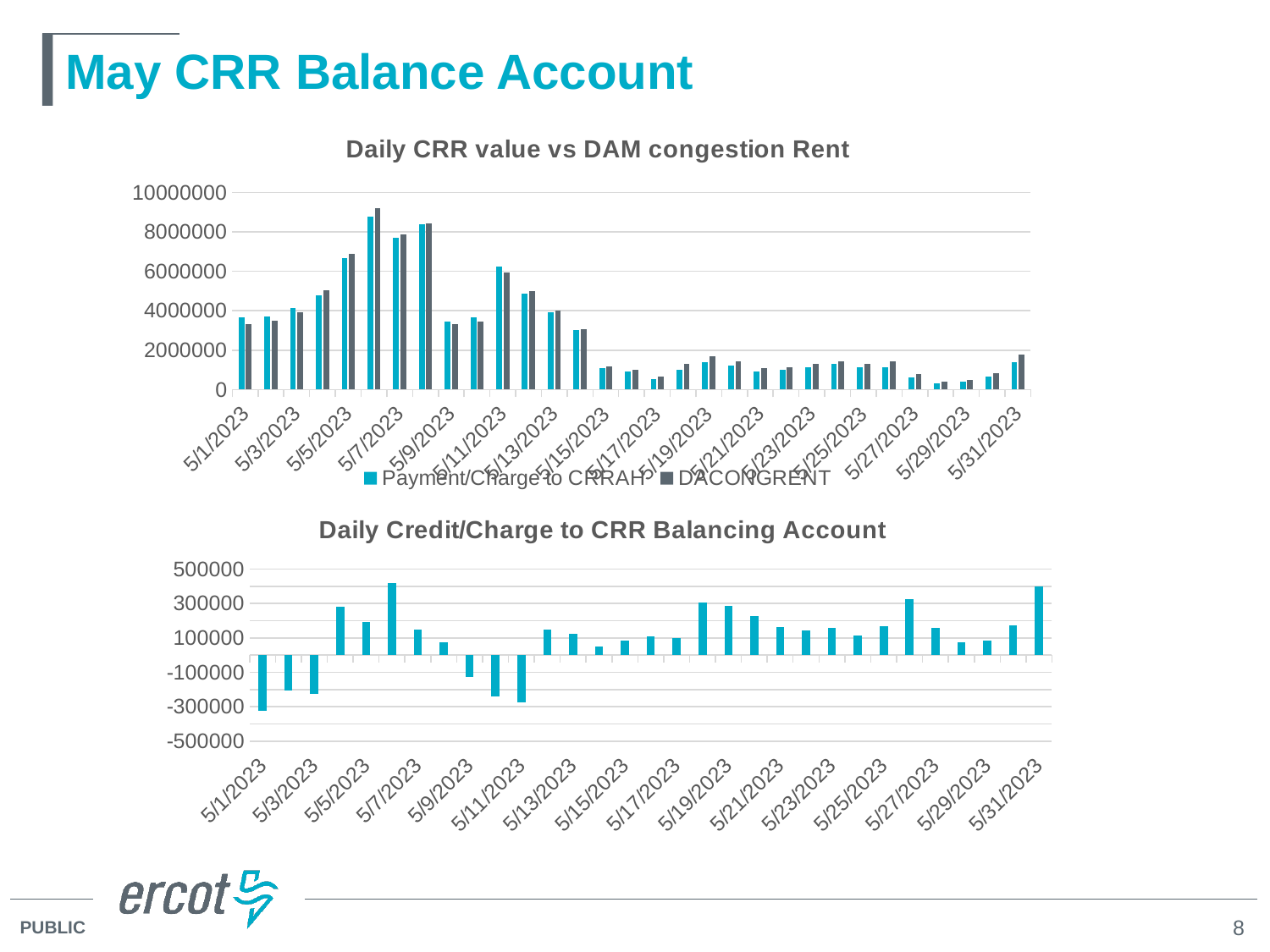
What type of chart is the bottom chart titled 'Daily Credit/Charge to CRR Balancing Account'? bar chart In the top chart 'Daily CRR value vs DAM congestion Rent', do the values generally rise or fall from 5/7/2023 to 5/15/2023? fall In the bottom chart 'Daily Credit/Charge to CRR Balancing Account', is the value for 5/31/2023 greater or less than 300000? greater In the top chart 'Daily CRR value vs DAM congestion Rent', is the DACONGRENT value for 5/15/2023 greater or less than 2000000? less How many series does the legend of the top chart 'Daily CRR value vs DAM congestion Rent' list? 2 In the bottom chart 'Daily Credit/Charge to CRR Balancing Account', which labeled date has the lowest value? 5/1/2023 In the bottom chart 'Daily Credit/Charge to CRR Balancing Account', is the value for 5/11/2023 greater or less than -100000? less In the top chart 'Daily CRR value vs DAM congestion Rent', what are the two series named in the legend? Payment/Charge to CRRAH and DACONGRENT What type of chart is the top chart titled 'Daily CRR value vs DAM congestion Rent'? bar chart In the top chart 'Daily CRR value vs DAM congestion Rent', which series has the larger value on 5/31/2023, Payment/Charge to CRRAH or DACONGRENT? DACONGRENT